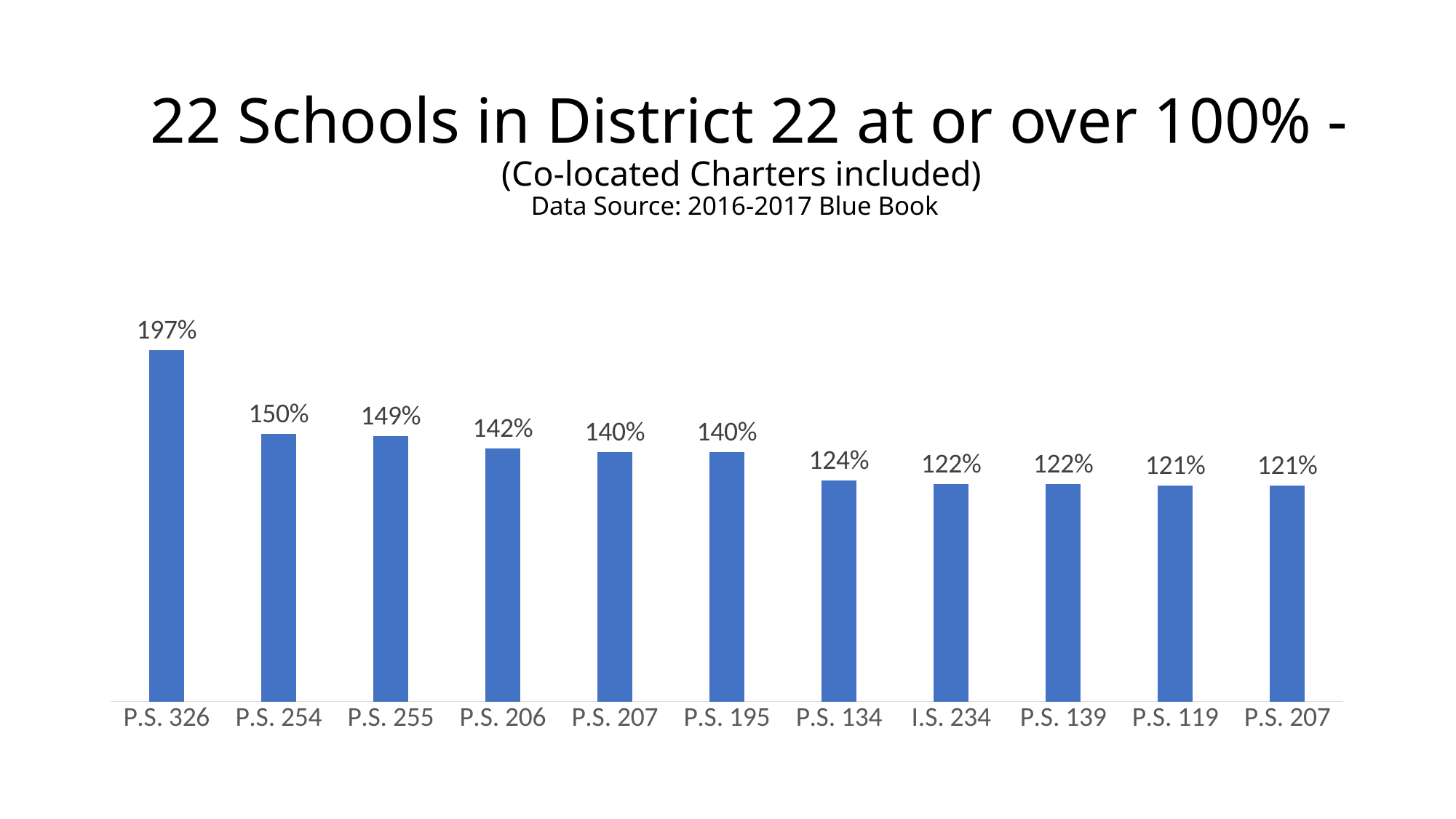
What is the value shown for P.S. 326? 197% What is the value shown for I.S. 234? 122% What kind of chart is shown on the slide? Bar chart What is the difference between the values for P.S. 326 and P.S. 254? 47% What is the value shown for P.S. 134? 124% What is the lowest value shown on the chart? 121% What is the difference between the values for P.S. 255 and P.S. 206? 7% Which school has the highest value on the chart? P.S. 326 How many schools are shown as bars on the chart? 11 What is the value shown for P.S. 254? 150% Which has a larger value, P.S. 195 or P.S. 134? P.S. 195 Do the values generally rise or fall from left to right across the chart? Fall